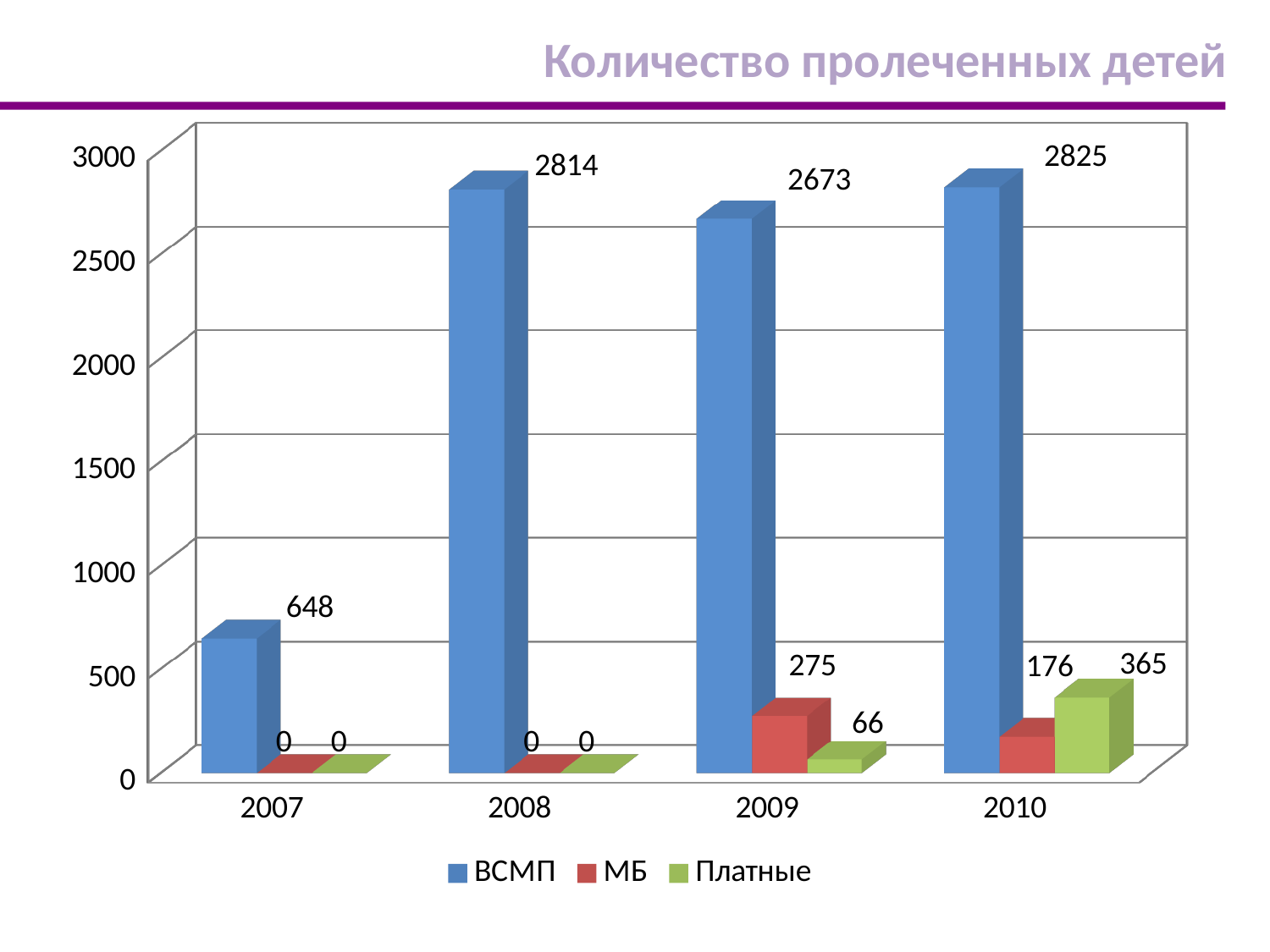
Which is larger in 2010: МБ or Платные? Платные What is the title of the chart? Количество пролеченных детей How many series does the legend list? 3 What is the value for МБ in 2009? 275 What is the difference between the ВСМП values for 2010 and 2009? 152 How many years are shown on the x axis? 4 What is the value for ВСМП in 2008? 2814 In which year is the ВСМП value highest? 2010 What is the value for Платные in 2010? 365 What kind of chart is shown on the slide? bar chart In which year is the ВСМП value lowest? 2007 Is the ВСМП value for 2007 greater or less than 1000? less